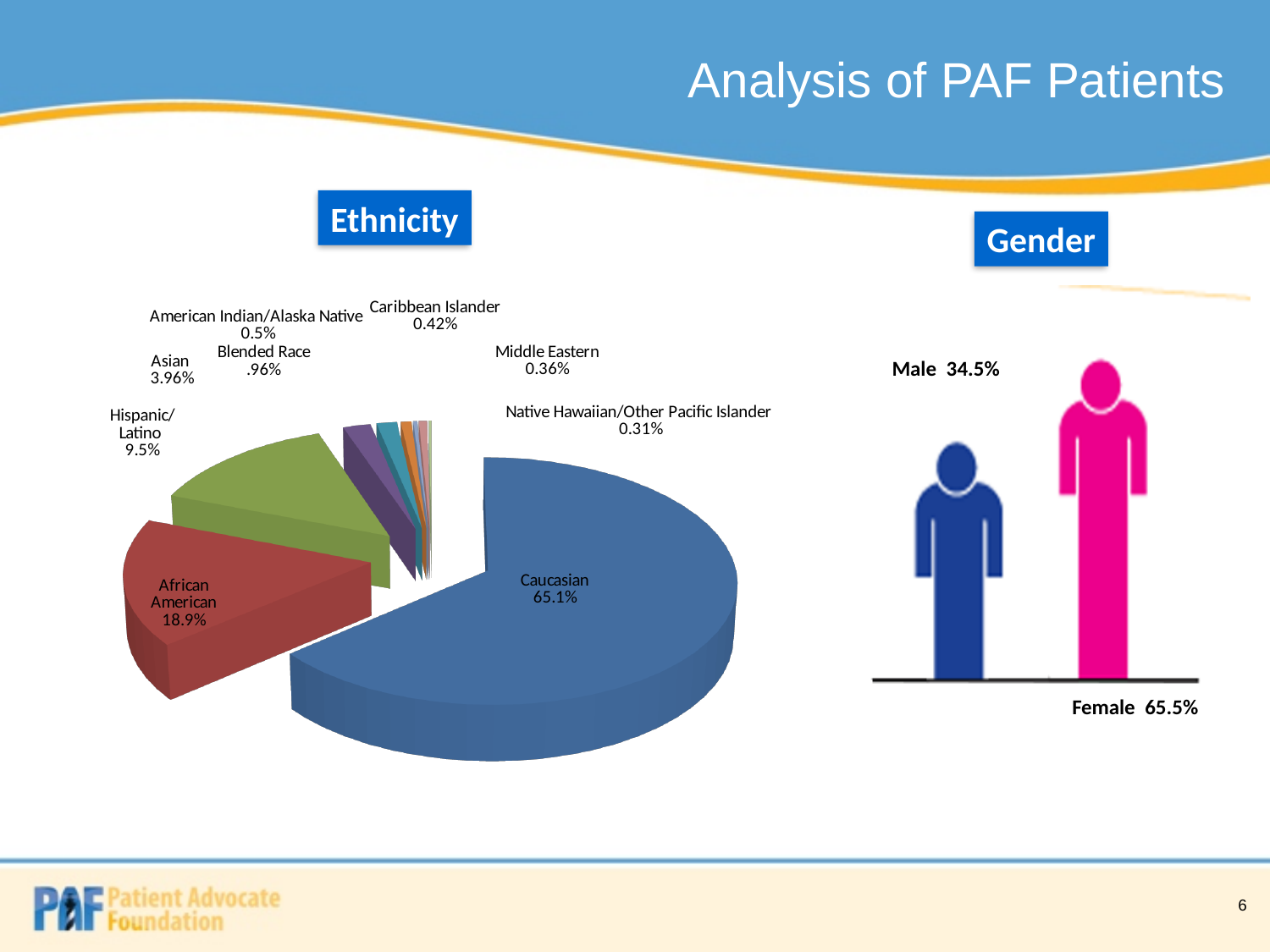
In the Ethnicity pie chart, what percentage of patients are African American? 18.9% In the Ethnicity pie chart, what is the value shown for Middle Eastern? 0.36% In the Ethnicity pie chart, which category has the largest share? Caucasian In the Gender graphic on the right, what percentage of patients are female? 65.5% In the Ethnicity pie chart, which is larger, the share for Hispanic/Latino or the share for Asian? Hispanic/Latino How many ethnicity categories are shown in the Ethnicity pie chart? 9 In the Ethnicity pie chart, which category has the smallest share? Native Hawaiian/Other Pacific Islander In the Ethnicity pie chart, what is the difference in percentage points between Caucasian and African American? 46.2 What type of chart is used to show Ethnicity on the slide? Pie chart In the Ethnicity pie chart, what is the value shown for Hispanic/Latino? 9.5% In the Ethnicity pie chart, what is the value shown for Asian? 3.96% In the Ethnicity pie chart, what percentage of patients are Caucasian? 65.1%